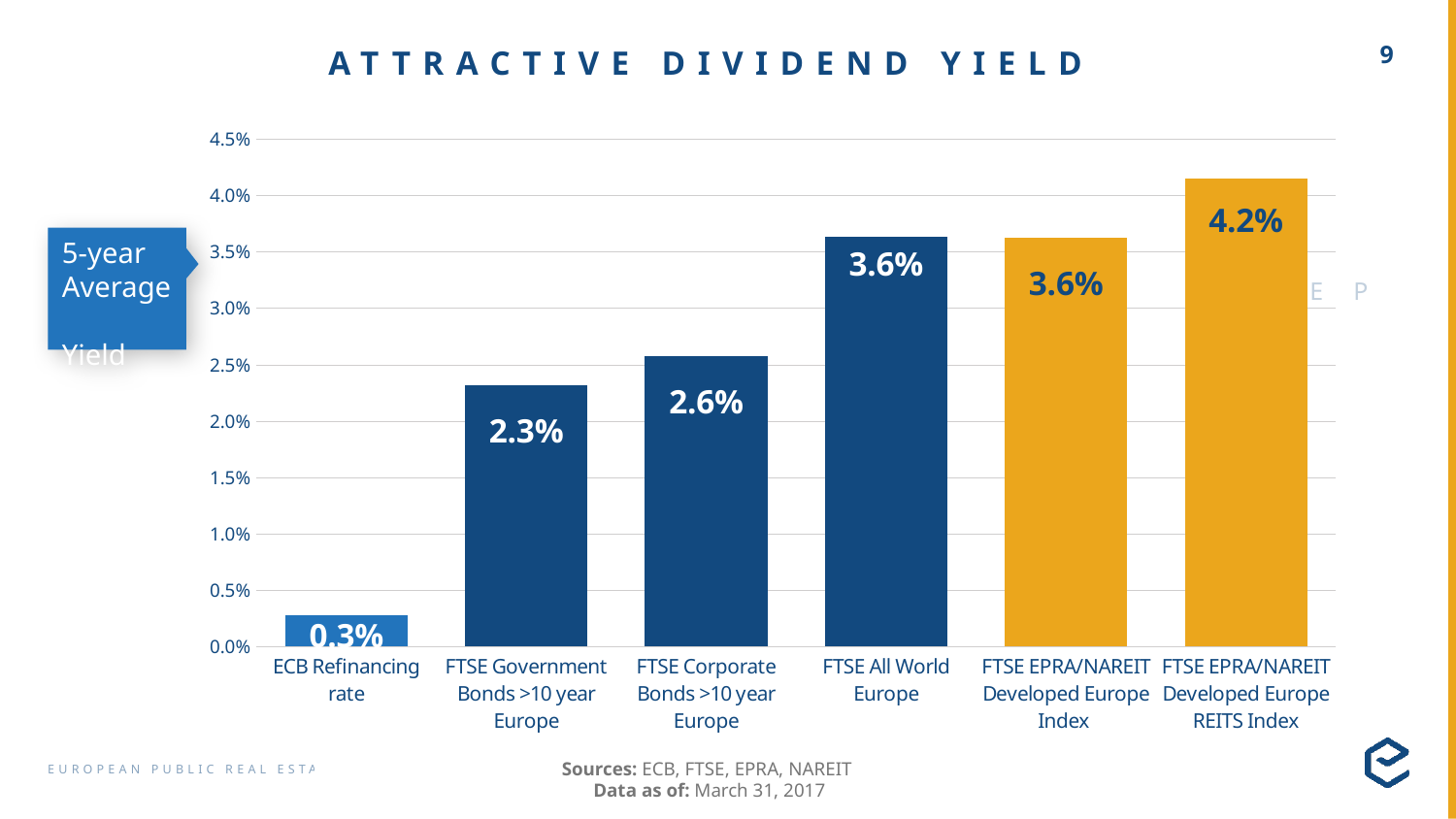
What is the title of the chart on the slide? Attractive Dividend Yield Which is larger: the yield for FTSE Corporate Bonds >10 year Europe or for FTSE Government Bonds >10 year Europe? FTSE Corporate Bonds >10 year Europe Which category has the lowest yield? ECB Refinancing rate How many categories are shown on the chart? 6 What is the value shown for FTSE Government Bonds >10 year Europe? 2.3% Is the value for FTSE All World Europe greater or less than 3.0%? greater What is the 5-year average yield for the FTSE EPRA/NAREIT Developed Europe REITS Index? 4.2% What kind of chart is shown on the slide? Bar chart What is the value shown for FTSE Corporate Bonds >10 year Europe? 2.6% What is the difference between the FTSE EPRA/NAREIT Developed Europe REITS Index yield and the FTSE Government Bonds >10 year Europe yield? 1.9% What is the value shown for the ECB Refinancing rate? 0.3% Which category has the highest yield? FTSE EPRA/NAREIT Developed Europe REITS Index